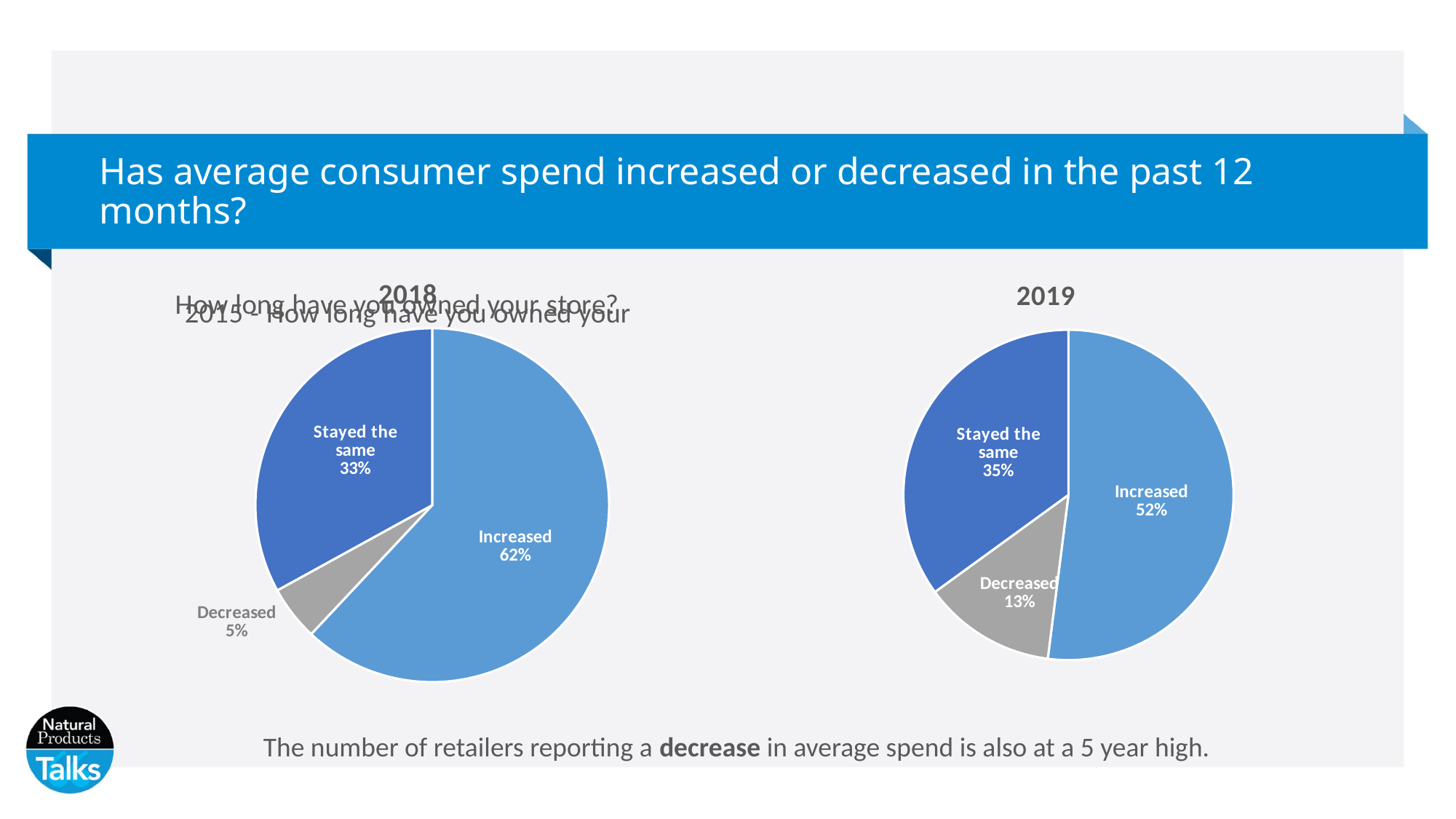
In the 2019 pie chart, what share of retailers reported that average consumer spend decreased? 13% In the 2018 pie chart, what is the difference between the 'Increased' and 'Stayed the same' shares? 29% What type of chart is used to show the 2018 data? Pie chart How many slices does the 2019 pie chart have? 3 In the 2019 pie chart, which category has the smallest share? Decreased Is the 'Increased' share larger in the 2018 pie chart or the 2019 pie chart? 2018 In the 2018 pie chart, what percentage is shown for 'Decreased'? 5% In the 2018 pie chart, which category has the largest share? Increased In the 2019 pie chart, what percentage is shown for 'Stayed the same'? 35% How much higher is the 'Decreased' share in the 2019 pie chart than in the 2018 pie chart? 8% In the 2018 pie chart, what share of retailers reported that average consumer spend increased? 62% What colour is the 'Decreased' slice in both pie charts? Grey